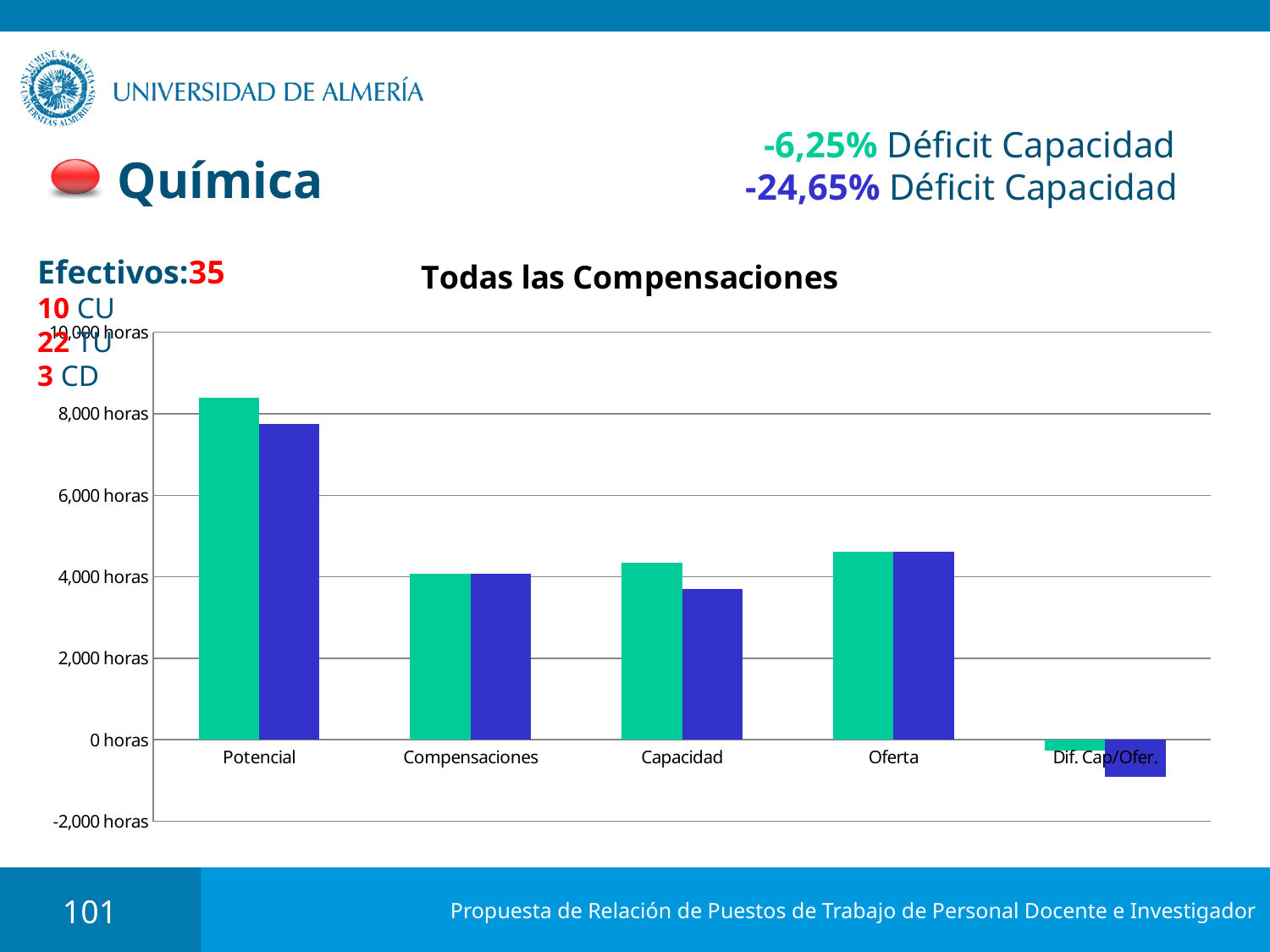
Which category has the lowest bars in the chart? Dif. Cap/Ofer. For Potencial, which bar is taller, the green one or the blue one? the green one What is the title of the chart? Todas las Compensaciones Is the green bar for Oferta greater or less than 4,000 horas? greater Are the bars for Dif. Cap/Ofer. above or below 0 horas? below How many categories are shown on the x axis of the chart? 5 For Capacidad, which bar is taller, the green one or the blue one? the green one What kind of chart is shown on the slide? bar chart Is the blue bar for Capacidad greater or less than 4,000 horas? less Which category has the tallest bars in the chart? Potencial